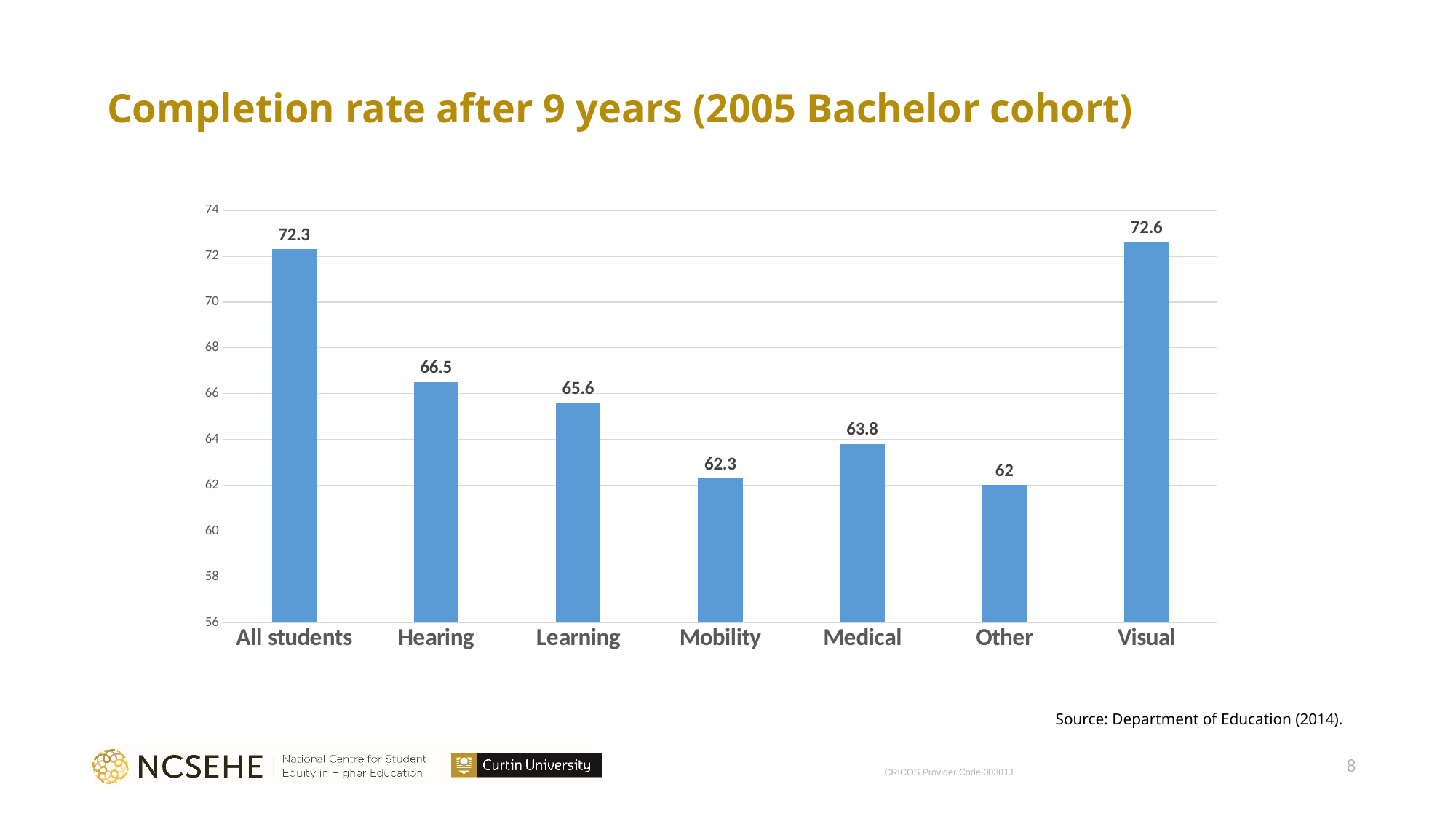
What kind of chart is shown on the slide? bar chart Which category has the lowest completion rate? Other What is the completion rate for Mobility? 62.3 How many categories are shown on the x axis? 7 What is the value shown for All students? 72.3 What is the title of the slide? Completion rate after 9 years (2005 Bachelor cohort) Is the value for Learning greater or less than 66? less What is the completion rate for Hearing? 66.5 What is the difference between the completion rates for Hearing and Learning? 0.9 Which category has the highest completion rate? Visual What is the difference between the completion rates for Visual and Other? 10.6 Which has a higher completion rate, Medical or Mobility? Medical